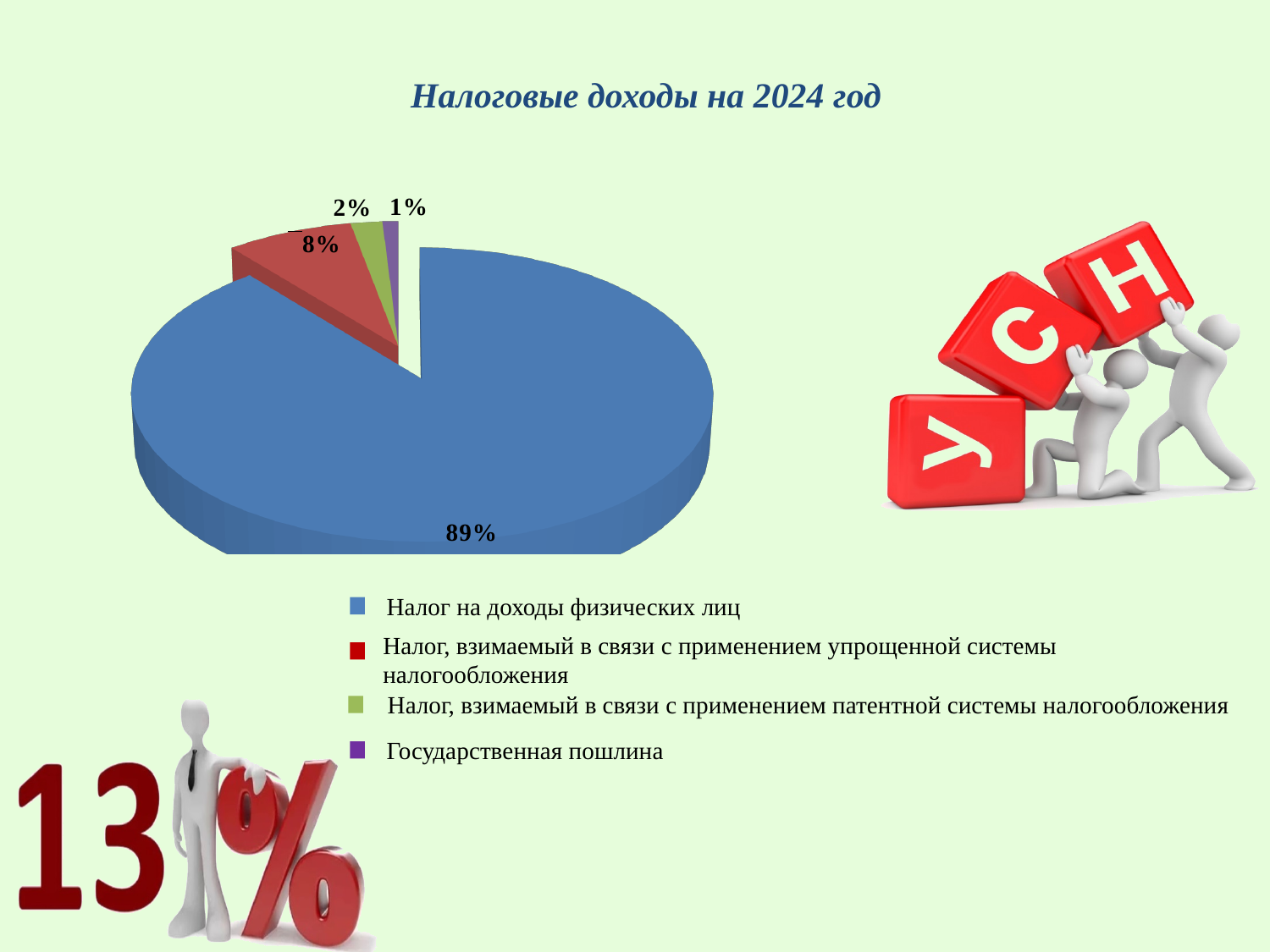
Which category has the smallest slice of the pie? Государственная пошлина What share of the pie does Государственная пошлина have? 1% What is the difference in percentage points between the share of Налог на доходы физических лиц and the share of Налог, взимаемый в связи с применением упрощенной системы налогообложения? 81 Which category has the largest slice of the pie? Налог на доходы физических лиц Which is larger: the share of Налог, взимаемый в связи с применением патентной системы налогообложения or the share of Государственная пошлина? Налог, взимаемый в связи с применением патентной системы налогообложения What share of the pie does Налог, взимаемый в связи с применением патентной системы налогообложения have? 2% How many slices does the pie chart have? 4 What kind of chart is shown on the slide? Pie chart What is the title of the chart? Налоговые доходы на 2024 год What share of the pie does Налог на доходы физических лиц have? 89% What colour is the slice for Налог на доходы физических лиц? Blue